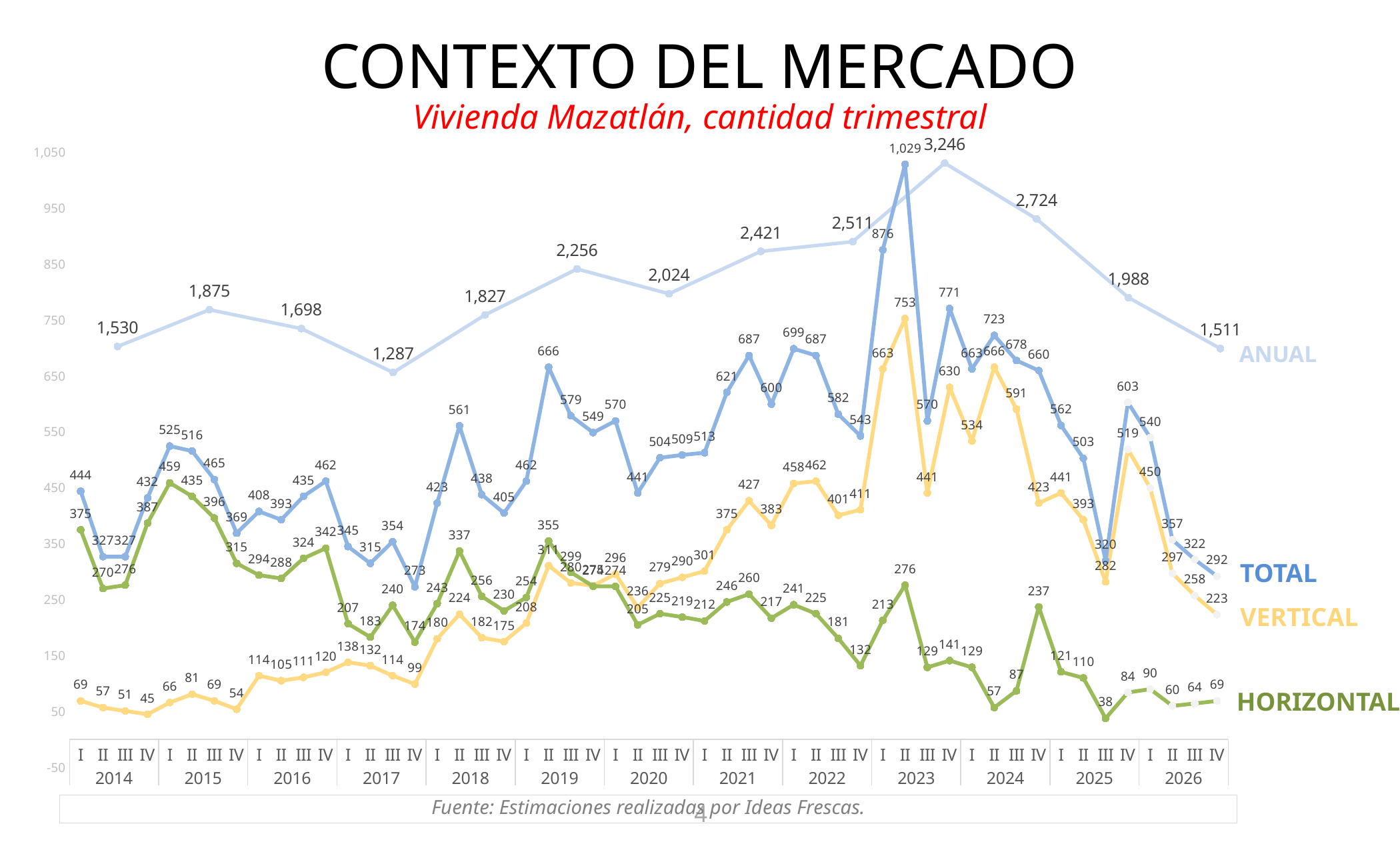
What is the difference between the ANUAL values for 2023 and 2024? 522 Which is larger, the TOTAL value for quarter II of 2023 or for quarter IV of 2023? quarter II of 2023 In which year is the ANUAL series at its lowest? 2017 Does the ANUAL series rise or fall from 2023 to 2026? fall In which year is the ANUAL series at its highest? 2023 How many years are shown on the x axis? 13 What is the HORIZONTAL value for quarter IV of 2026? 69 What is the ANUAL value for 2023? 3,246 What kind of chart is shown on the slide? line chart What is the VERTICAL value for quarter II of 2023? 753 How many series are plotted in the chart? 4 What is the TOTAL value for quarter II of 2023? 1,029